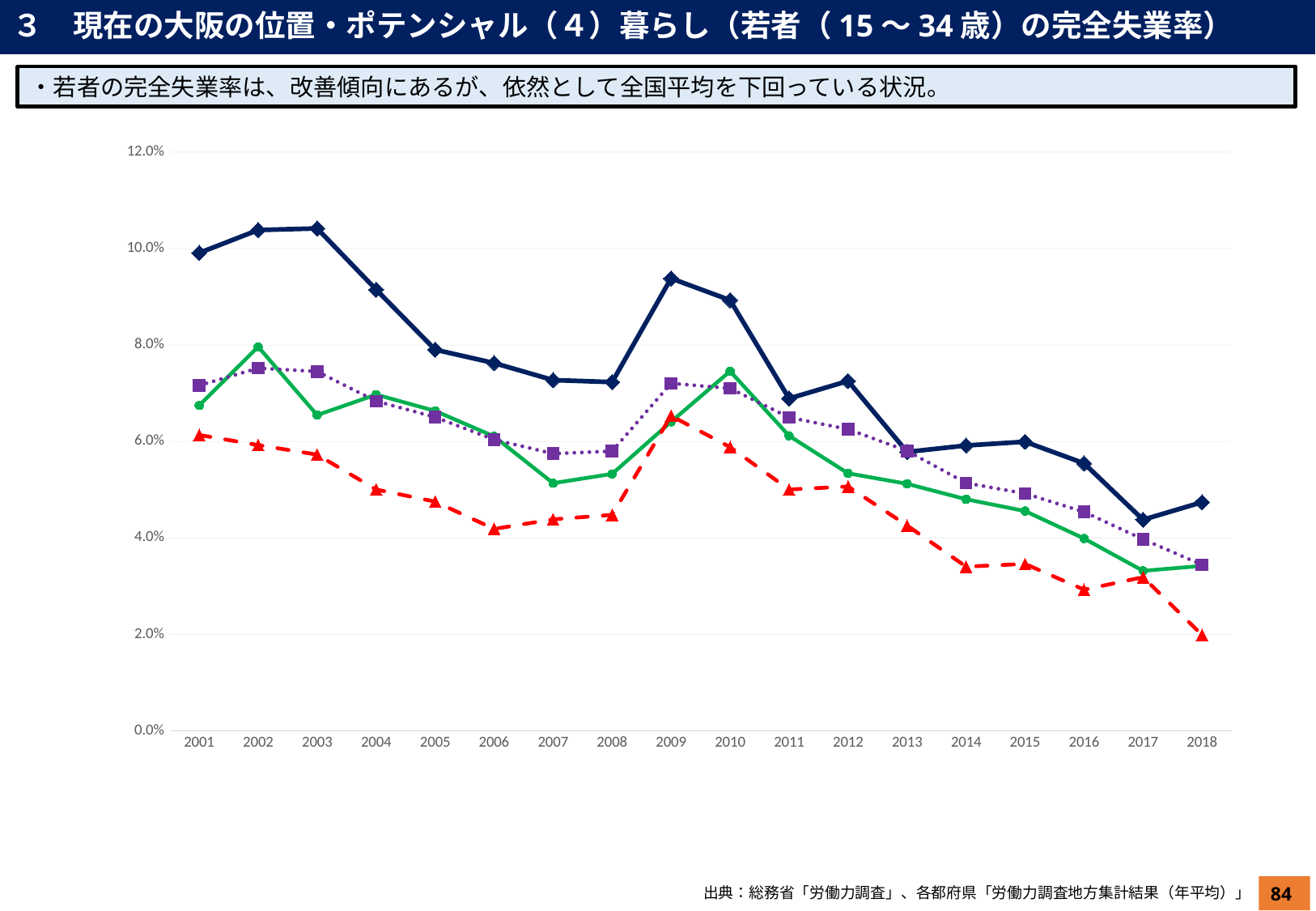
In 2018, which is larger: the dark navy line or the green line? the dark navy line Is the value of the purple dotted line in 2016 greater or less than 4.0%? greater In which year is the green line at its highest? 2002 Is the value of the green line in 2007 greater or less than 6.0%? less What kind of chart is shown on the slide? line chart How many years are plotted along the x axis? 18 What is the range of years shown on the x axis? 2001 to 2018 Is the value of the red dashed line in 2018 greater or less than 4.0%? less Does the dark navy line with diamond markers generally rise or fall from 2001 to 2018? fall What is the highest value shown on the y axis? 12.0% In which year is the red dashed line at its lowest? 2018